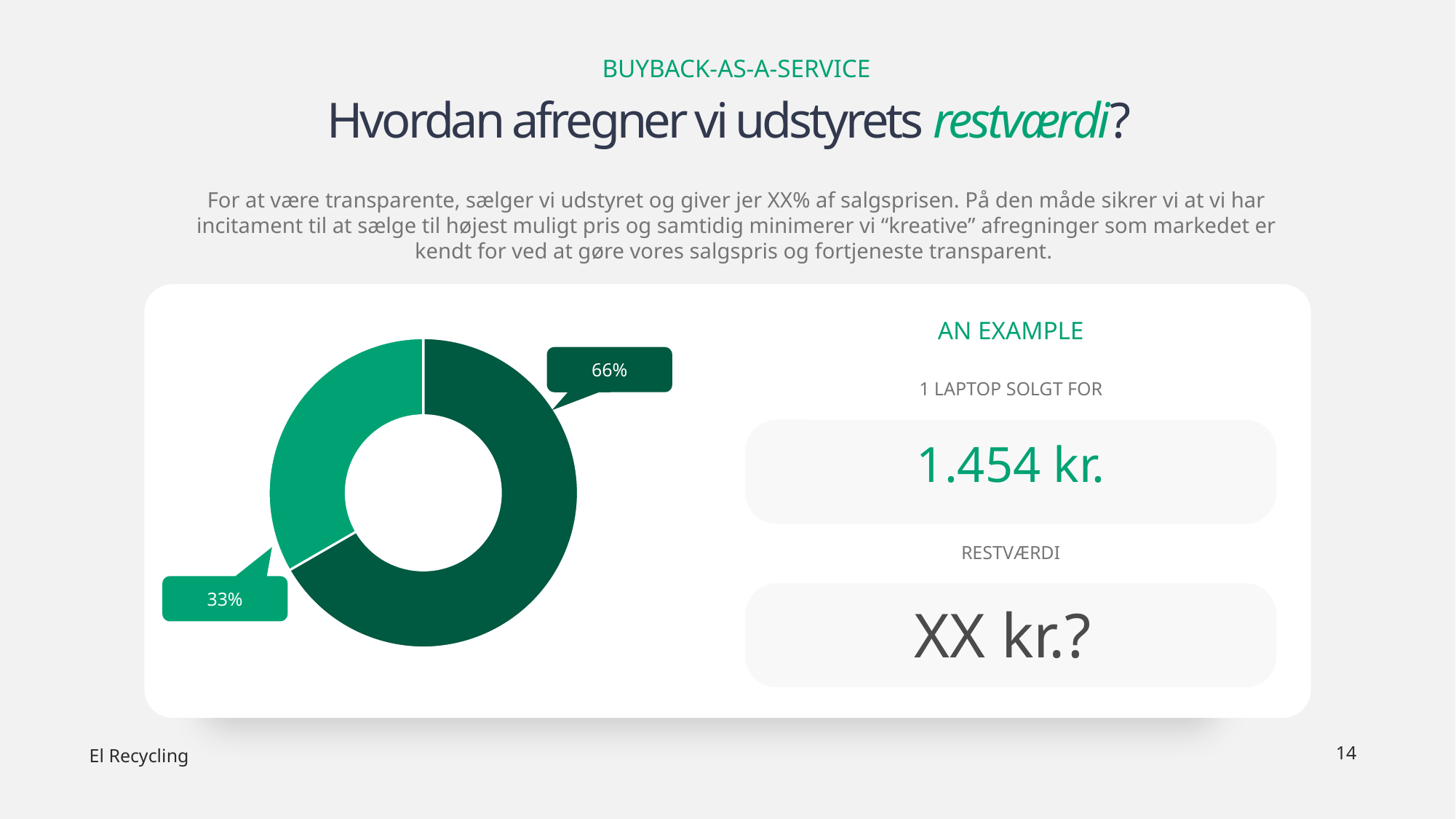
Is the value of the dark green slice greater or less than 50%? greater What is the difference between the two slice values in the donut chart? 33% Is the value of the lighter green slice greater or less than 50%? less Which slice is larger, the dark green one or the lighter green one? the dark green one What share of the donut does the dark green slice represent? 66% How many slices does the donut chart have? 2 What percentage is shown for the dark green slice of the donut chart? 66% What percentage is shown for the lighter green slice of the donut chart? 33% Which slice of the donut chart is the smallest? the lighter green slice (33%) Which slice of the donut chart is the largest? the dark green slice (66%) What kind of chart is shown on the slide? pie chart (donut) What colour is the slice labelled 33%? lighter green